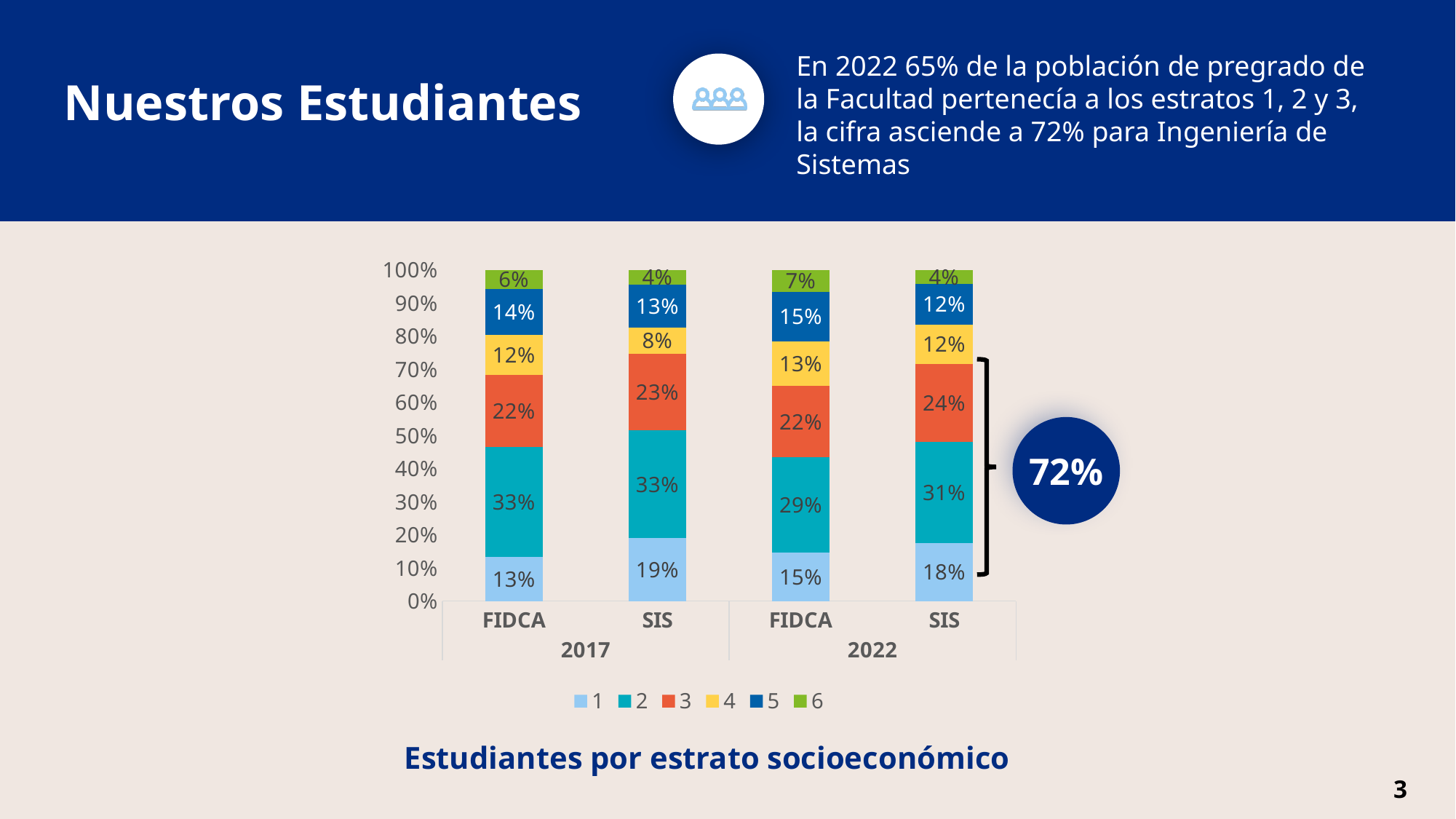
How many bars are plotted in the chart? 4 How many series does the legend list? 6 Which bar has the highest value for series 3? SIS 2022 What is the value for series 4 in the SIS 2017 bar? 8% What kind of chart is shown on the slide? Stacked bar chart What is the value for series 1 in the SIS 2017 bar? 19% What is the value for series 6 in the FIDCA 2022 bar? 7% What is the difference between the series 1 values for SIS 2017 and FIDCA 2017? 6% Which bar has the lowest value for series 1? FIDCA 2017 Which is larger: the series 5 value for FIDCA 2022 or for SIS 2022? FIDCA 2022 What is the value for series 2 in the FIDCA 2022 bar? 29% What is the combined share of series 1, 2 and 3 in the SIS 2022 bar? 72%